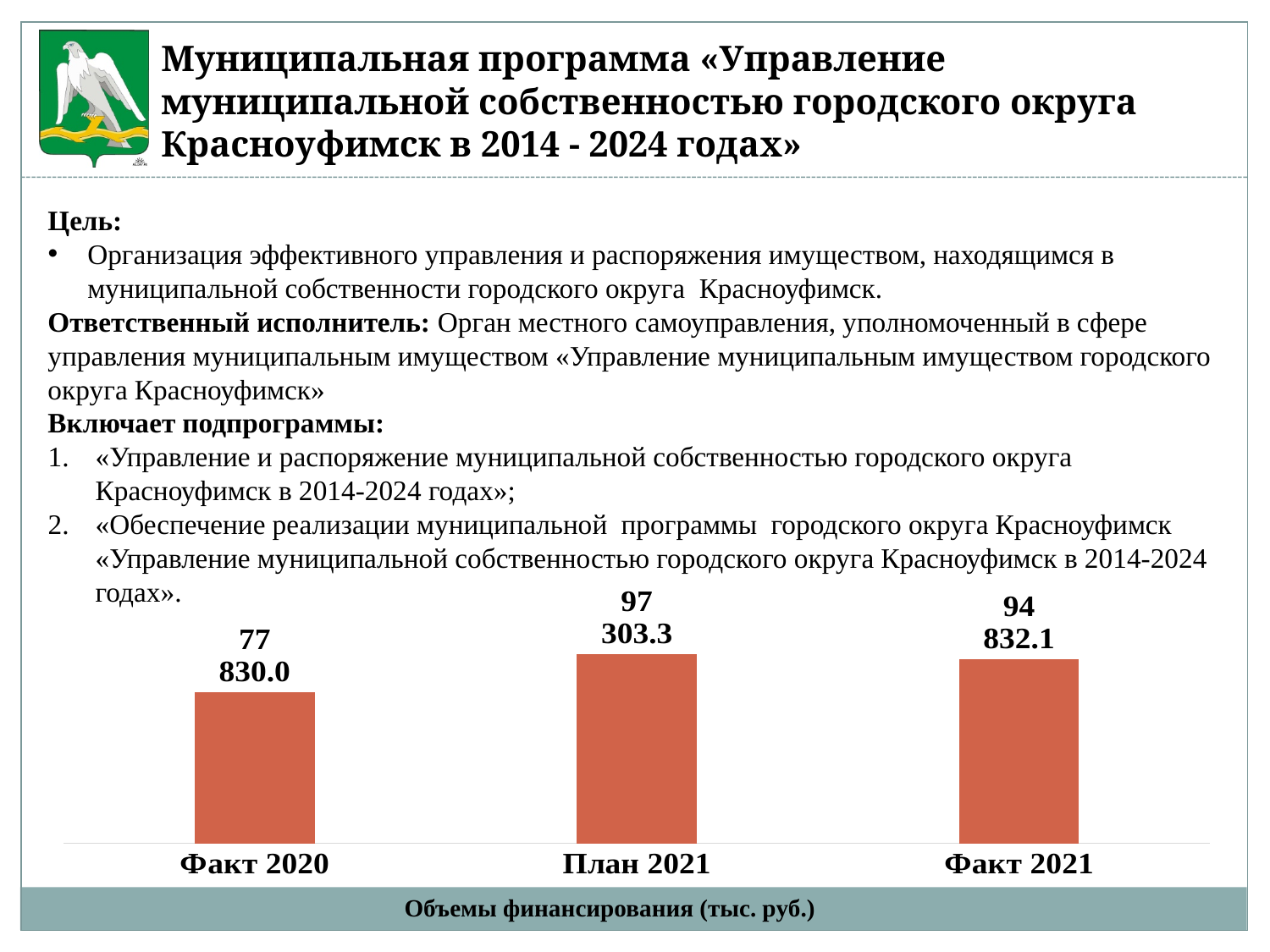
What kind of chart is «Объемы финансирования (тыс. руб.)»? Bar chart What is the value for План 2021 in the chart «Объемы финансирования (тыс. руб.)»? 97 303.3 What unit is given in the title of the chart at the bottom of the slide? тыс. руб. Which category has the highest value in the chart «Объемы финансирования (тыс. руб.)»? План 2021 What is the difference between План 2021 and Факт 2021 in the chart «Объемы финансирования (тыс. руб.)»? 2 471.2 Does the value rise or fall from Факт 2020 to План 2021 in the chart «Объемы финансирования (тыс. руб.)»? Rise What is the value for Факт 2021 in the chart «Объемы финансирования (тыс. руб.)»? 94 832.1 Which is larger in the chart «Объемы финансирования (тыс. руб.)»: Факт 2020 or Факт 2021? Факт 2021 How many categories are shown in the chart «Объемы финансирования (тыс. руб.)»? 3 What is the difference between Факт 2021 and Факт 2020 in the chart «Объемы финансирования (тыс. руб.)»? 17 002.1 Which category has the lowest value in the chart «Объемы финансирования (тыс. руб.)»? Факт 2020 What is the value for Факт 2020 in the chart «Объемы финансирования (тыс. руб.)»? 77 830.0